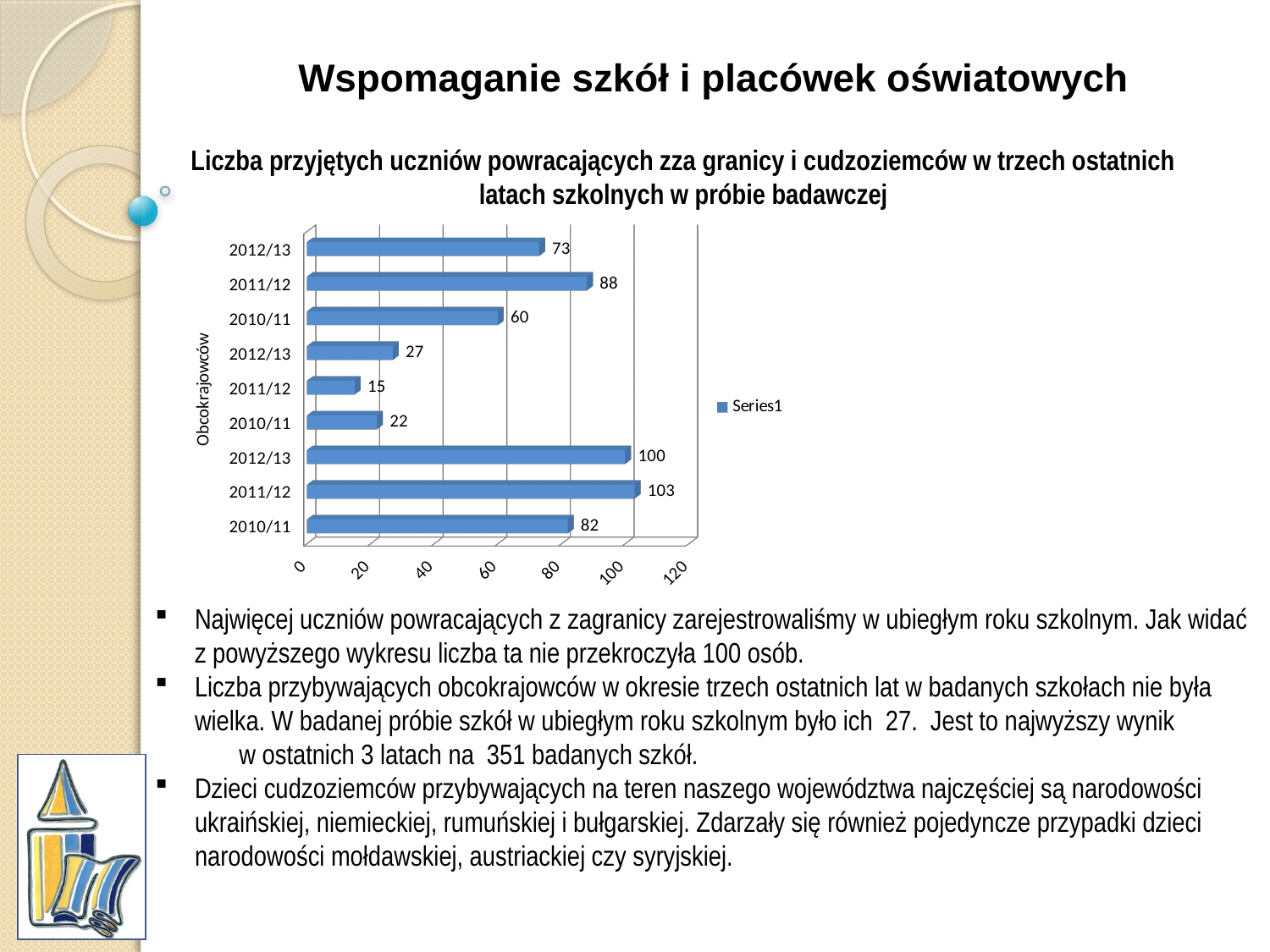
What is the value of the bottom bar (2010/11) in the chart? 82 What is the value of the topmost bar (2012/13) in the chart? 73 Which is larger: the topmost 2012/13 bar or the 2012/13 bar in the bottom group? the 2012/13 bar in the bottom group What is the difference between the 2011/12 bar (88) and the 2010/11 bar (60) in the top group? 28 What is the lowest value shown on any bar in the chart? 15 What is the name of the series shown in the legend? Series1 What is the value of the 2012/13 bar in the middle group of bars (next to the 'Obcokrajowców' axis label)? 27 What kind of chart is shown on the slide? bar chart How many bars are plotted in the chart? 9 How many series does the chart legend list? 1 What is the difference between the two largest bars in the chart (103 and 100)? 3 What is the highest value shown on any bar in the chart? 103